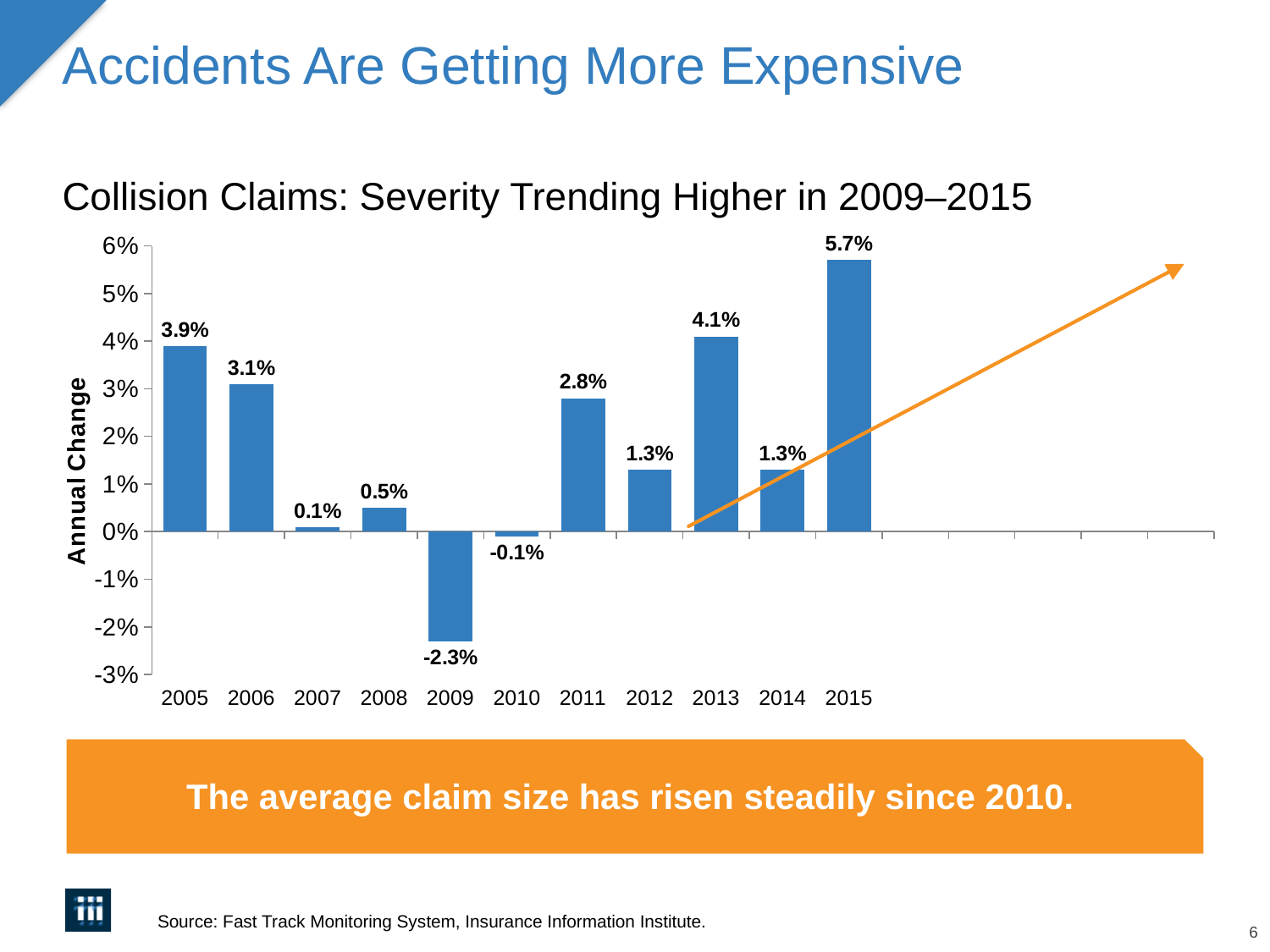
Do the annual change values rise or fall from 2009 to 2015? Rise What kind of chart is used to show the annual change in collision claim severity? Bar chart Is the value for 2013 greater or less than 3%? greater What is the title of the chart? Collision Claims: Severity Trending Higher in 2009–2015 What is the annual change shown for 2011? 2.8% How many years are shown on the x axis of the chart? 11 Which year has the lowest annual change? 2009 Which year has a larger annual change, 2005 or 2006? 2005 Which year has the highest annual change? 2015 What is the annual change in collision claim severity for 2015? 5.7% What is the annual change shown for 2009? -2.3% What is the difference between the annual change in 2015 and in 2013? 1.6%